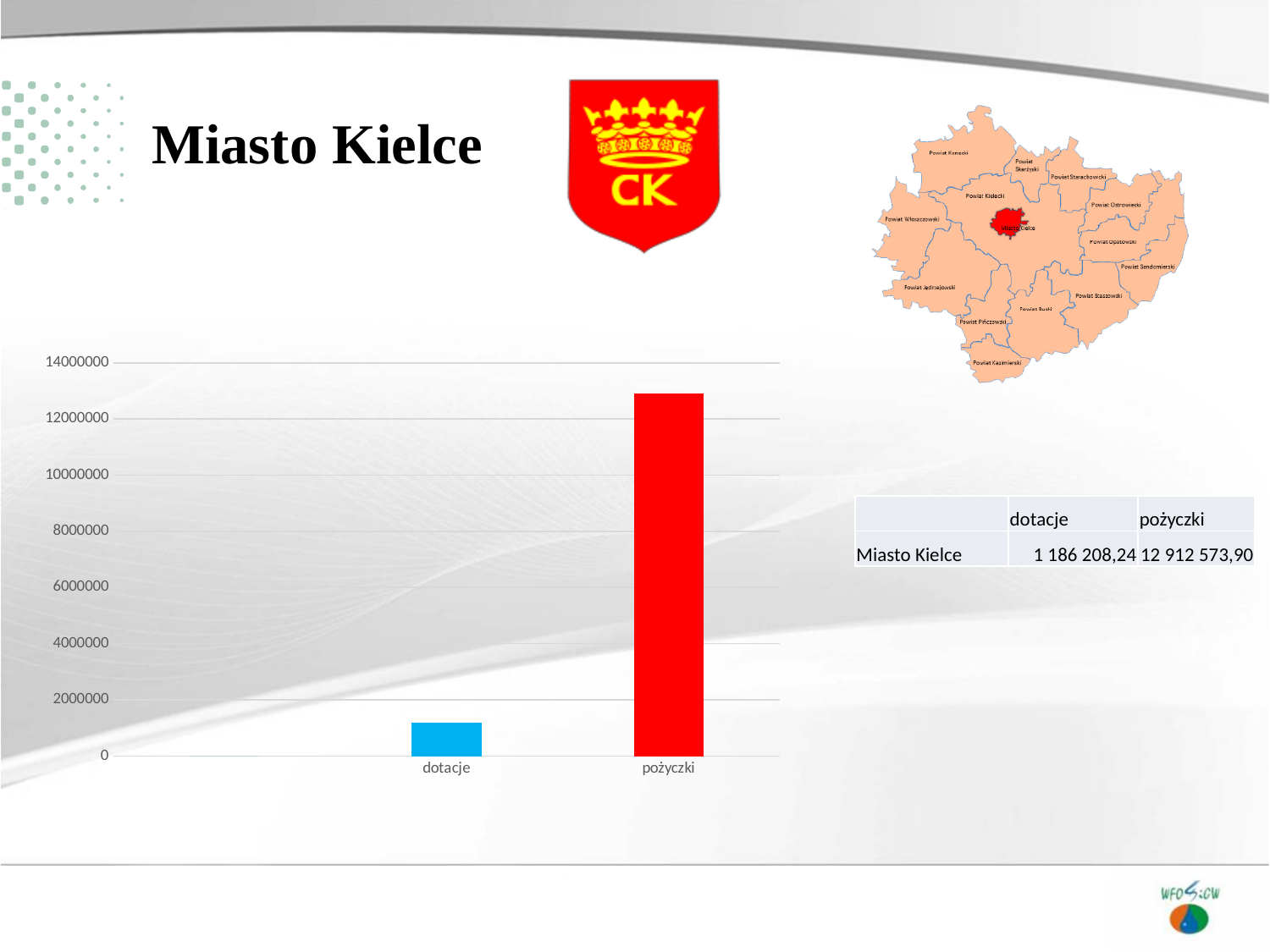
According to the table on the slide, what is the value of pożyczki for Miasto Kielce? 12 912 573,90 According to the table on the slide, what is the value of dotacje for Miasto Kielce? 1 186 208,24 Using the values in the table, what is the difference between pożyczki and dotacje for Miasto Kielce? 11 726 365,66 What kind of chart is shown on the slide? bar chart Is the value for pożyczki greater or less than 12000000? greater How many categories does the bar chart show? 2 Is the value for dotacje greater or less than 2000000? less What colour is the bar for pożyczki? red Which is larger, the value for dotacje or the value for pożyczki? pożyczki Which category has the lowest bar in the chart? dotacje Which category has the highest bar in the chart? pożyczki What colour is the bar for dotacje? blue